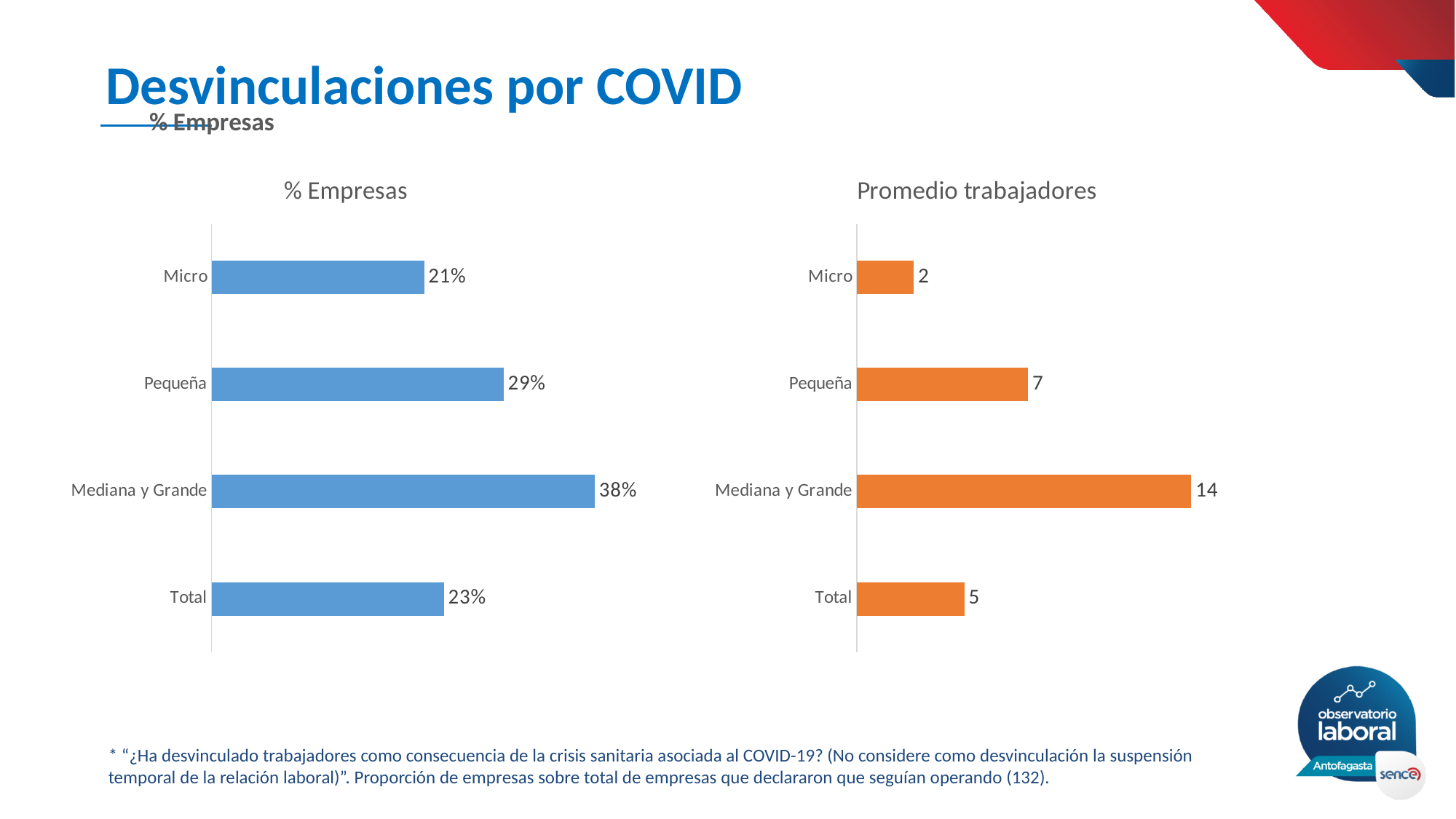
In the 'Promedio trabajadores' chart, which category has the lowest value? Micro In the 'Promedio trabajadores' chart, what is the value for Mediana y Grande? 14 In the '% Empresas' chart, what is the difference between Mediana y Grande and Micro? 17% In the 'Promedio trabajadores' chart, what is the value for Total? 5 In the '% Empresas' chart, what is the value for Pequeña? 29% What colour are the bars in the '% Empresas' chart? Blue In the '% Empresas' chart, which category has the highest value? Mediana y Grande How many categories are shown in the '% Empresas' chart? 4 In the 'Promedio trabajadores' chart, which is larger, Pequeña or Micro? Pequeña What kind of chart is the 'Promedio trabajadores' chart? Bar chart In the 'Promedio trabajadores' chart, what is the difference between Pequeña and Total? 2 In the '% Empresas' chart, which is larger, Total or Micro? Total